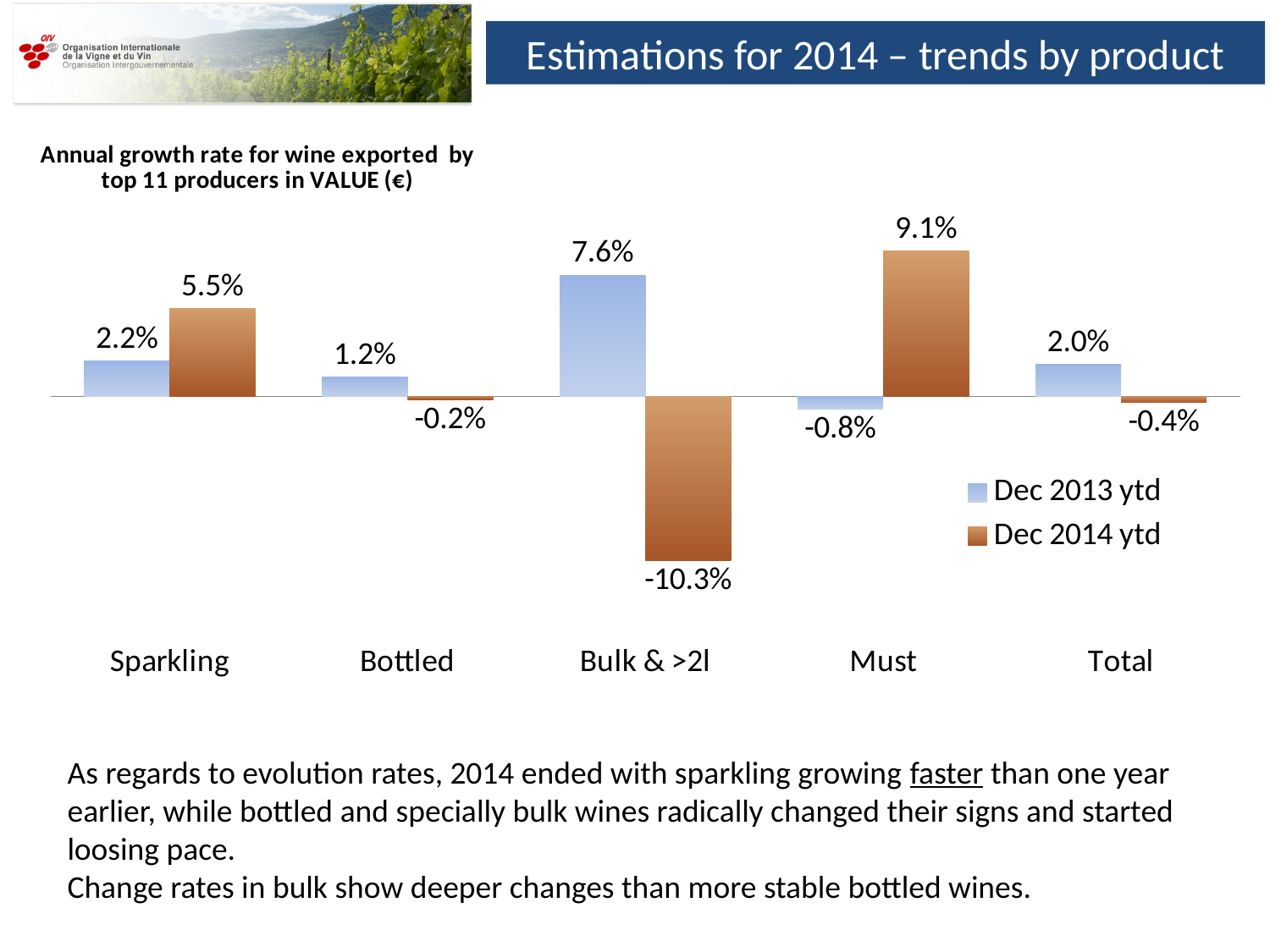
How many product categories are shown on the x axis? 5 What is the difference between the Dec 2014 ytd and Dec 2013 ytd growth rates for Sparkling? 3.3% How many series does the legend list? 2 Which category has the lowest Dec 2014 ytd growth rate? Bulk & >2l What is the Dec 2014 ytd growth rate for Sparkling? 5.5% What is the Dec 2014 ytd growth rate for Total? -0.4% Which category has the lowest Dec 2013 ytd growth rate? Must What kind of chart is shown on the slide? Bar chart What is the Dec 2013 ytd growth rate for Bulk & >2l? 7.6% Which is larger for Bottled: the Dec 2013 ytd or the Dec 2014 ytd growth rate? Dec 2013 ytd Which category has the highest Dec 2014 ytd growth rate? Must What is the Dec 2014 ytd growth rate for Must? 9.1%